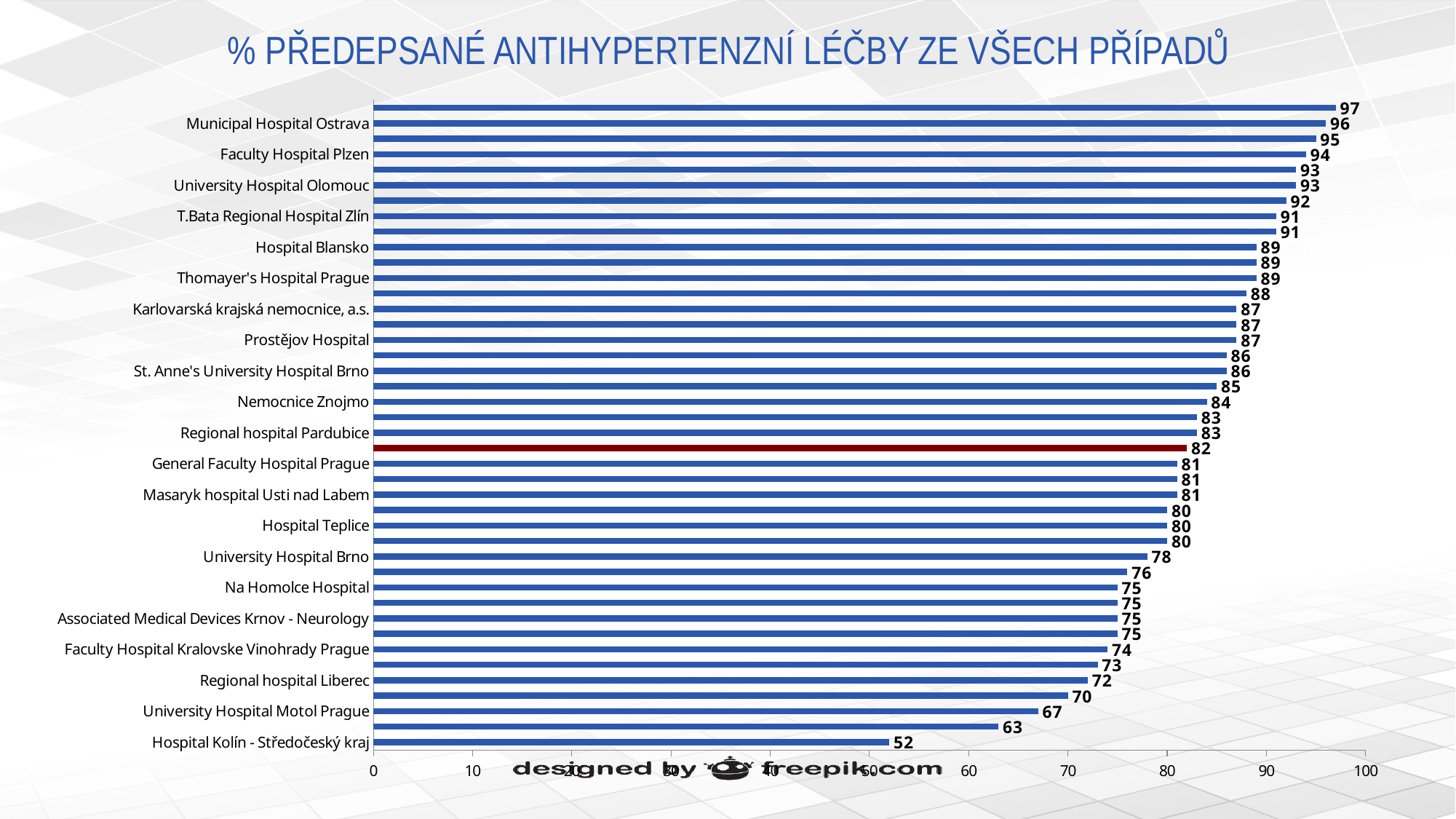
What kind of chart is shown on the slide? bar chart What is the value for Nemocnice Znojmo? 84 What is the highest value shown on the chart? 97 What is the value of the red (dark red) bar? 82 What is the value for Hospital Kolín - Středočeský kraj? 52 Which labelled hospital has the lowest value? Hospital Kolín - Středočeský kraj What is the value for University Hospital Motol Prague? 67 Which is larger, the value for University Hospital Brno or the value for Hospital Teplice? Hospital Teplice What is the title of the chart? % PŘEDEPSANÉ ANTIHYPERTENZNÍ LÉČBY ZE VŠECH PŘÍPADŮ What is the difference between the values for Faculty Hospital Plzen and Regional hospital Liberec? 22 What is the value for Municipal Hospital Ostrava? 96 Is the value for T.Bata Regional Hospital Zlín greater or less than 90? greater